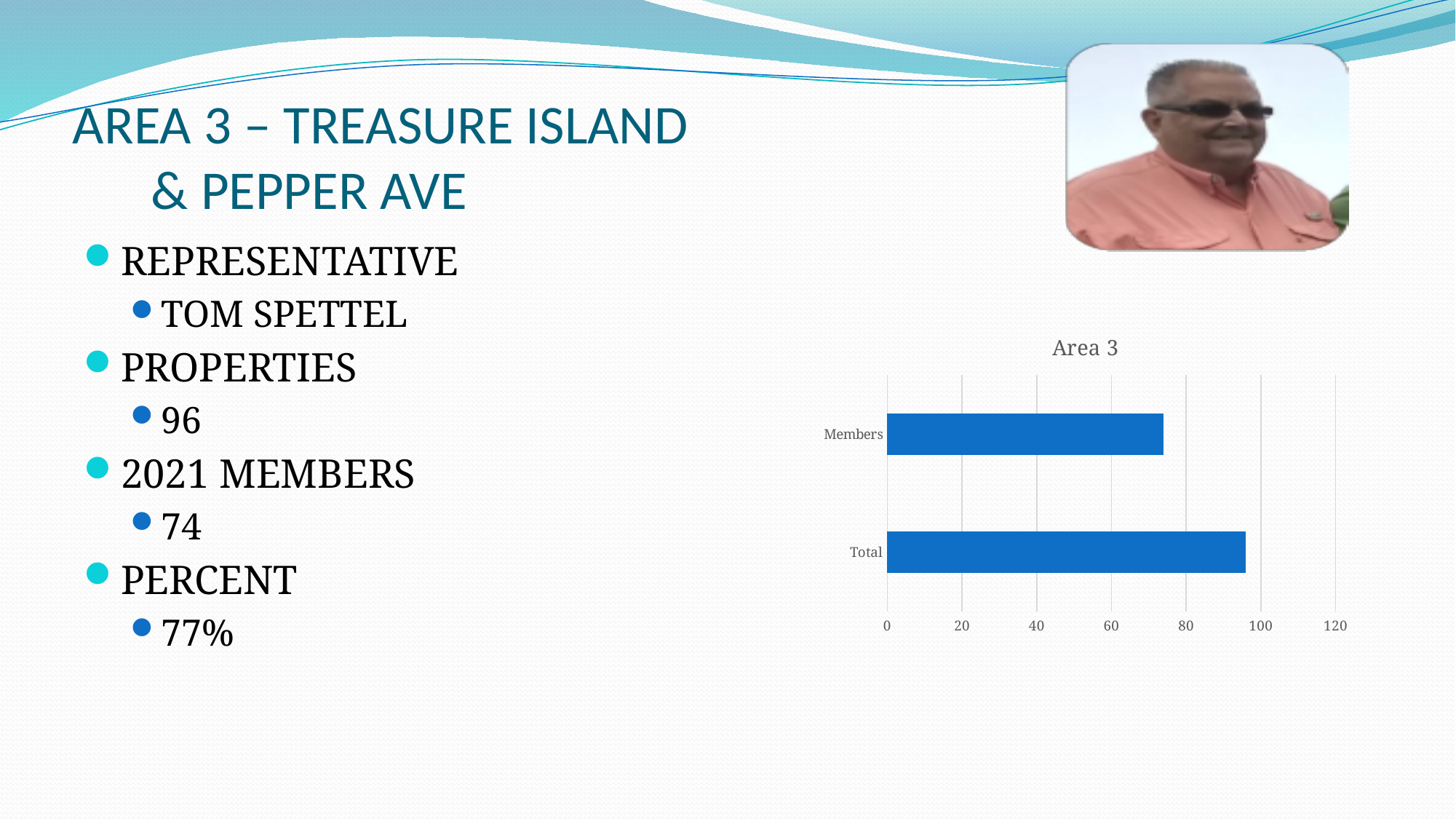
How many categories does the chart show? 2 Which category is listed at the top of the chart? Members Is the bar for Total longer or shorter than the bar for Members? longer Is the value for Members greater or less than 60? greater Is the value for Members greater or less than 80? less What is the highest value shown on the chart's horizontal axis? 120 What is the title of the chart? Area 3 Is the value for Total greater or less than 100? less What kind of chart is shown on the slide? bar chart Which category has the shortest bar in the chart? Members Which category has the longest bar in the chart? Total